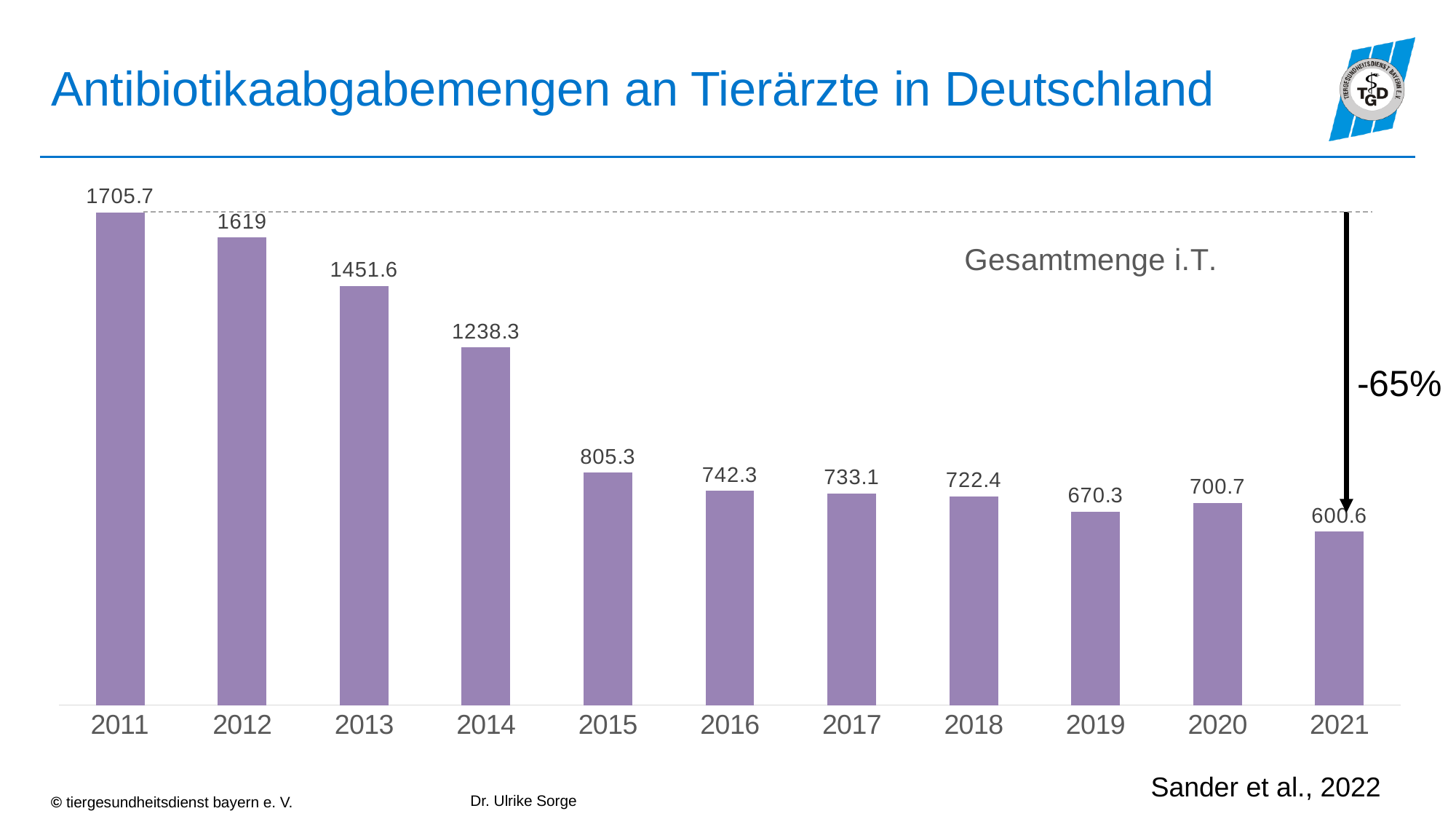
Which is larger, the value for 2019 or the value for 2020? 2020 Which year has the lowest value? 2021 What is the value for 2021? 600.6 Which year has the highest value? 2011 What kind of chart is shown on the slide? bar chart How many years are shown on the x axis? 11 What is the value for 2011? 1705.7 What is the difference between the values for 2014 and 2015? 433 What is the difference between the values for 2011 and 2021? 1105.1 What is the value for 2019? 670.3 What is the value for 2015? 805.3 Do the values generally rise or fall from 2011 to 2021? fall